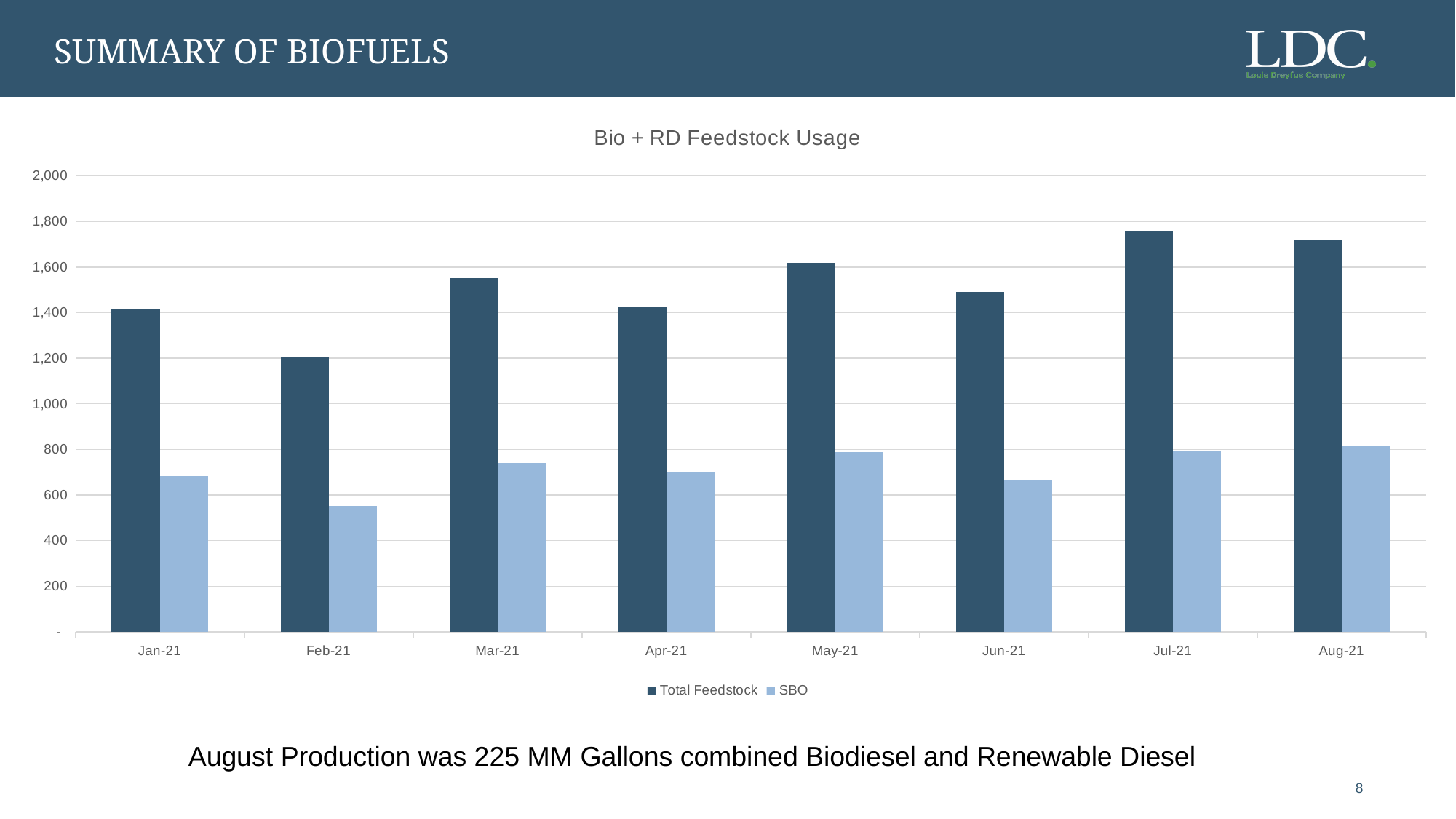
Is the Total Feedstock value for Jul-21 greater or less than 1,600? greater What kind of chart is shown on the slide? Bar chart What is the title of the chart? Bio + RD Feedstock Usage Is the SBO value for Feb-21 greater or less than 600? less Which month has the lowest SBO value? Feb-21 Is the Total Feedstock value for Feb-21 greater or less than 1,400? less Which is larger, the Total Feedstock value for Mar-21 or for Feb-21? Mar-21 Which month has the lowest Total Feedstock value? Feb-21 How many series does the legend list? 2 Which is larger, the SBO value for May-21 or for Jun-21? May-21 How many months are shown on the x axis? 8 Which month has the highest Total Feedstock value? Jul-21